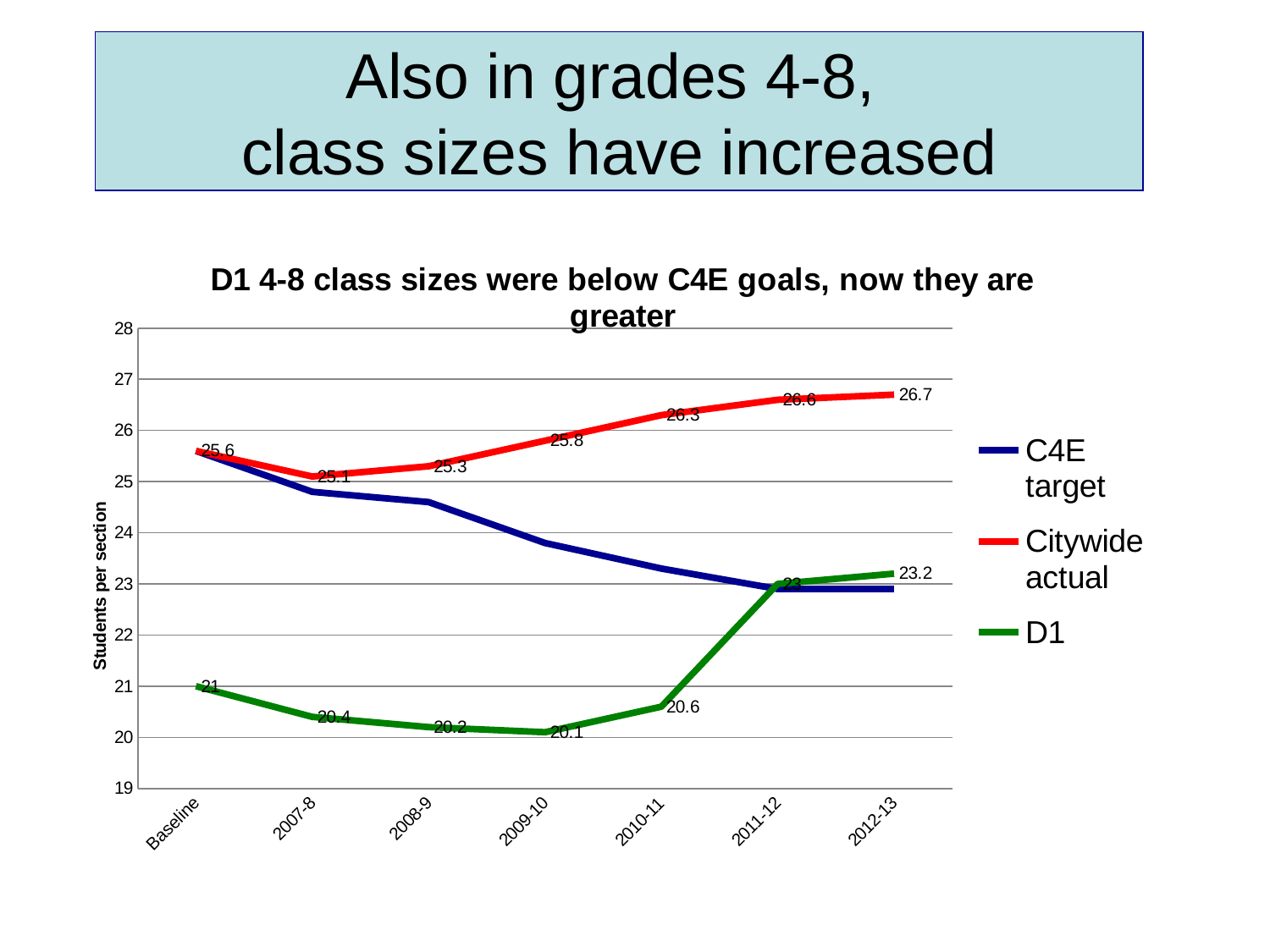
Is the C4E target value for 2009-10 greater or less than 24? less What is the D1 value for 2009-10? 20.1 What is the difference between the D1 values for 2012-13 and 2011-12? 0.2 How many series does the legend list? 3 What is the Citywide actual value for 2012-13? 26.7 How many time points are shown on the x axis? 7 In 2011-12, which is larger: Citywide actual or D1? Citywide actual In which year is the D1 value lowest? 2009-10 Does the D1 line rise or fall from 2009-10 to 2012-13? rise In which year is the Citywide actual value highest? 2012-13 By how much did the Citywide actual value increase from Baseline to 2012-13? 1.1 What kind of chart is shown on the slide? line chart